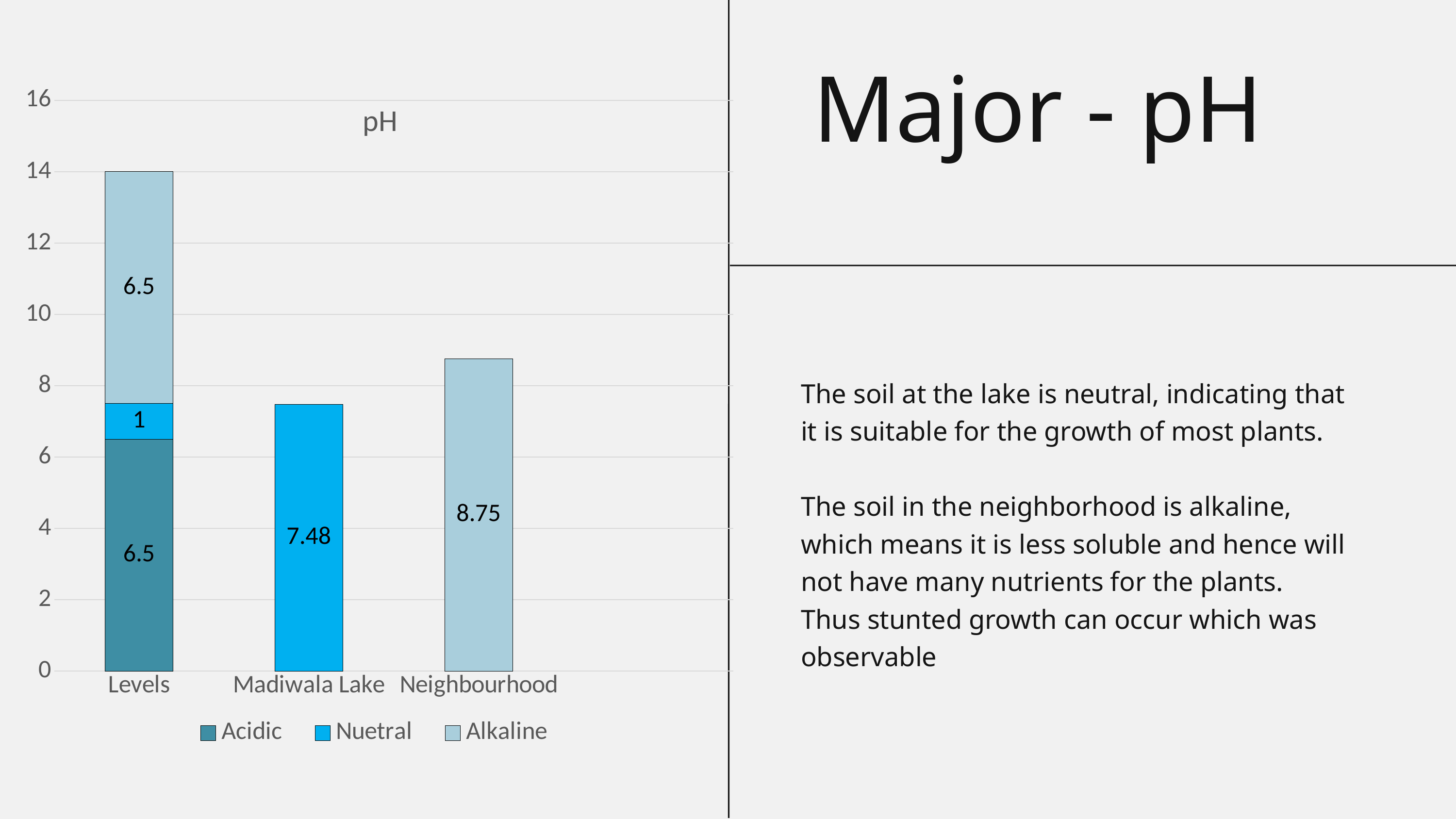
What is the Acidic value for the Levels bar? 6.5 How many categories are shown on the x axis? 3 What is the Alkaline value for Neighbourhood? 8.75 What is the total height of the stacked Levels bar? 14 What is the Nuetral value for Madiwala Lake? 7.48 What is the Nuetral value in the Levels bar? 1 What is the difference between the Neighbourhood value and the Madiwala Lake value? 1.27 Is the value for Madiwala Lake greater or less than 8? less Which is larger, the Madiwala Lake value or the Neighbourhood value? Neighbourhood What kind of chart is shown on the slide? Stacked bar chart Which category has the tallest bar overall? Levels How many series does the legend list? 3